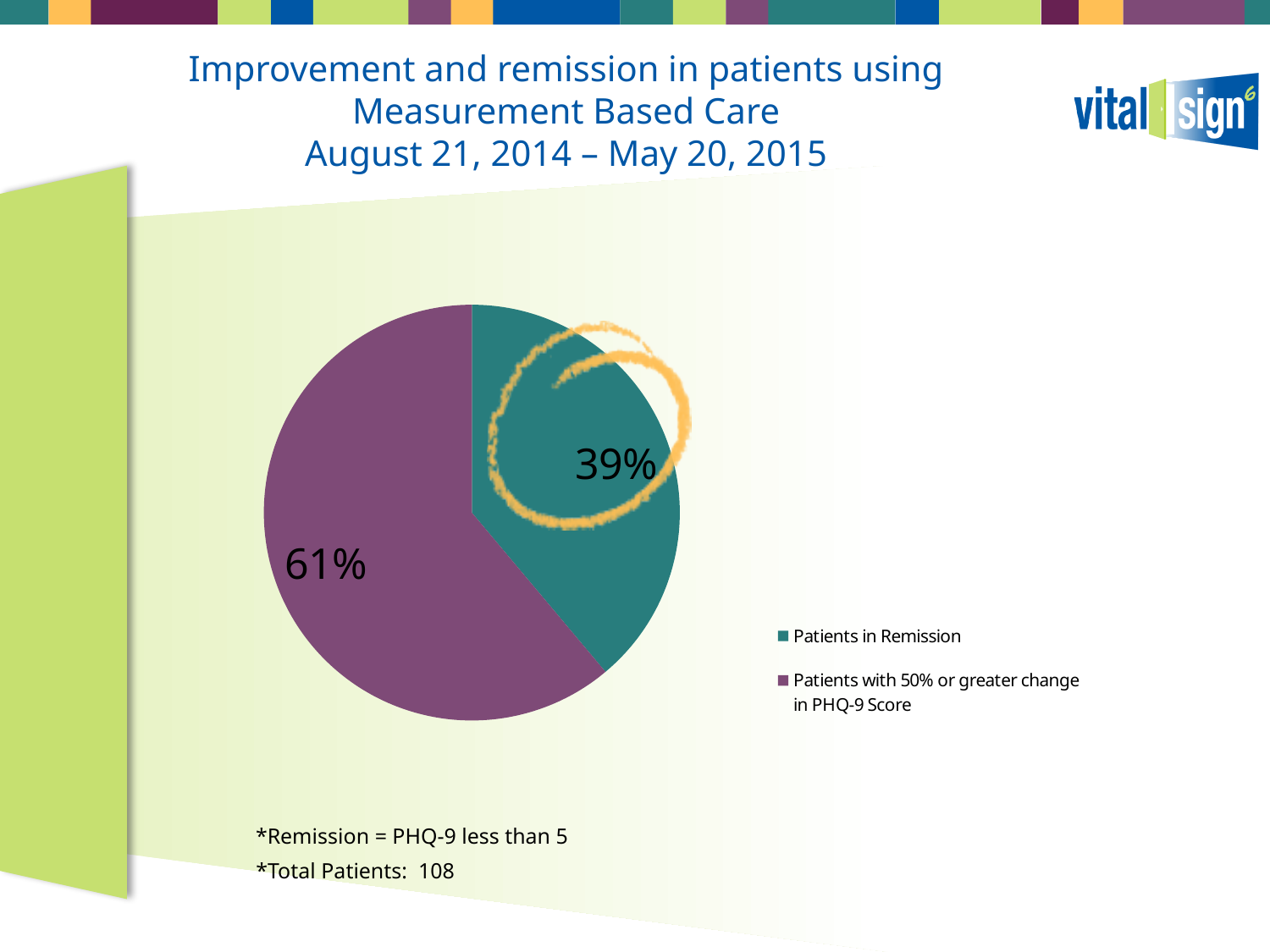
How many slices does the pie chart have? 2 Which slice is larger: Patients in Remission or Patients with 50% or greater change in PHQ-9 Score? Patients with 50% or greater change in PHQ-9 Score What share of the pie does the Patients in Remission slice represent? 39% What colour is the slice for Patients in Remission? Teal What percentage of the pie is labelled for Patients in Remission? 39% What is the total number of patients noted on the slide? 108 Which category has the smallest slice of the pie? Patients in Remission How many entries does the legend list? 2 What is the difference in percentage points between the two slices of the pie? 22 Which category has the largest slice of the pie? Patients with 50% or greater change in PHQ-9 Score What percentage of the pie is labelled for Patients with 50% or greater change in PHQ-9 Score? 61% What kind of chart is shown on the slide? Pie chart